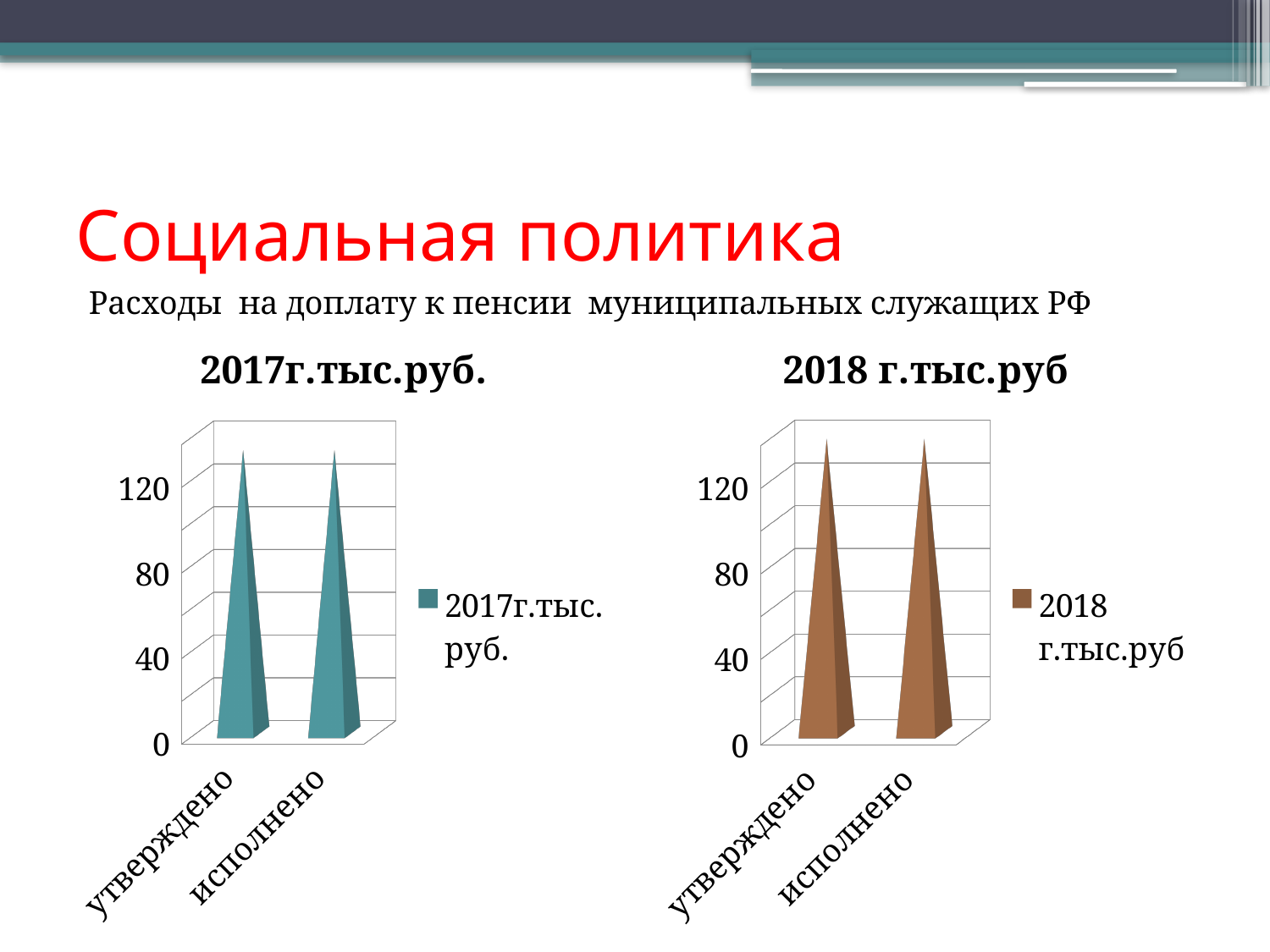
In the chart titled "2018 г.тыс.руб", what is the highest tick label shown on the y axis? 120 In the chart titled "2017г.тыс.руб.", is the value for исполнено greater or less than 80? greater In the chart titled "2017г.тыс.руб.", is the value for утверждено greater or less than 120? greater In the chart titled "2017г.тыс.руб.", what are the two category labels on the x axis? утверждено, исполнено In the chart titled "2018 г.тыс.руб", how many series does the legend list? 1 In the chart titled "2018 г.тыс.руб", is the value for утверждено greater or less than 120? greater In the chart titled "2017г.тыс.руб.", what kind of chart is shown? bar chart In the chart titled "2017г.тыс.руб.", how many series does the legend list? 1 What is the legend entry of the chart on the right side of the slide? 2018 г.тыс.руб In the chart titled "2018 г.тыс.руб", how many categories are shown on the x axis? 2